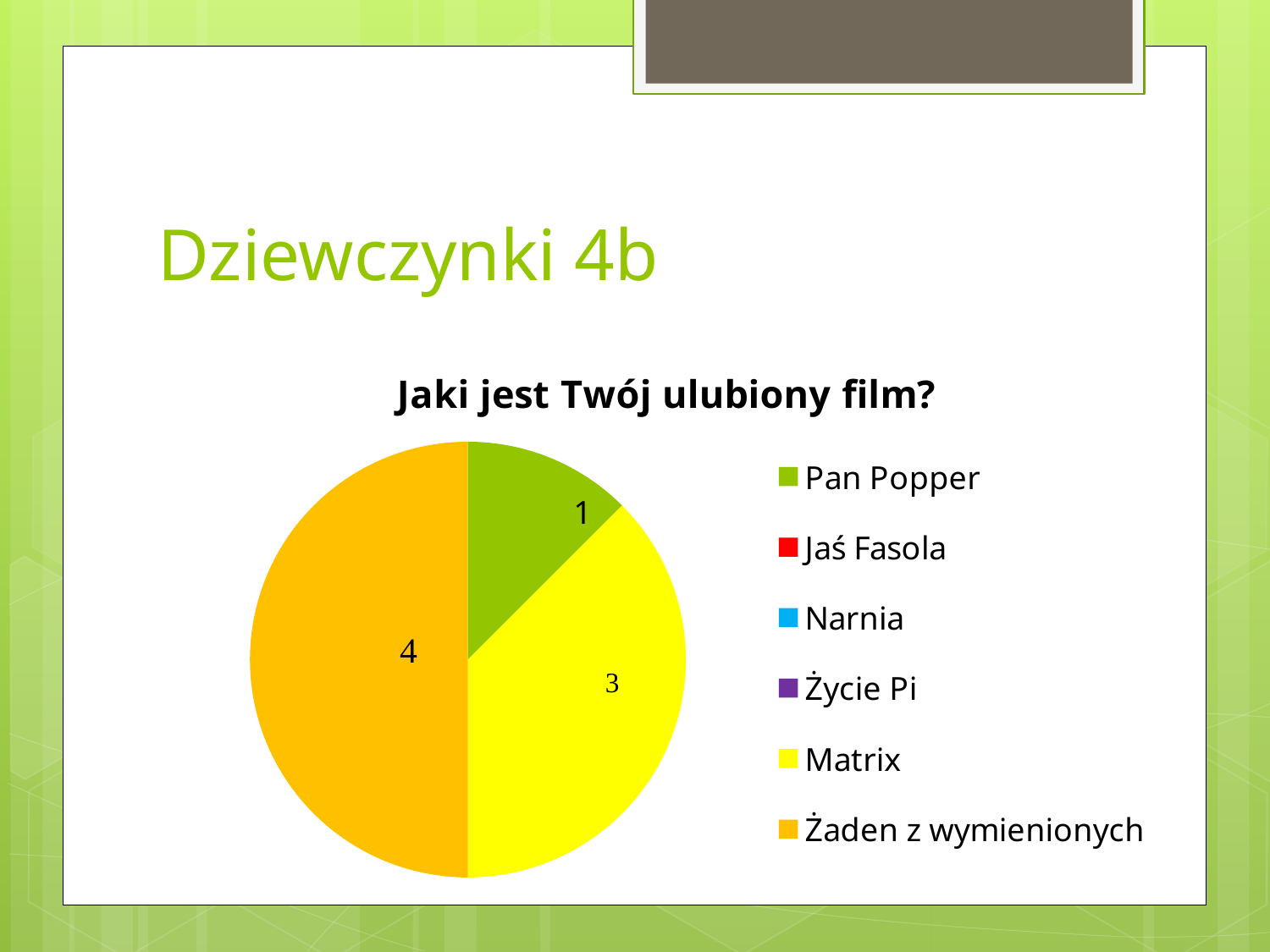
What is the difference between the values for Żaden z wymienionych and Matrix? 1 What is the value for Matrix? 3 How many slices are visible in the pie chart? 3 What is the value for Żaden z wymienionych? 4 What type of chart is shown on the slide? pie chart What share of the pie does Żaden z wymienionych represent? 50% Which is larger, the value for Matrix or the value for Pan Popper? Matrix How many entries does the chart legend list? 6 What is the value for Pan Popper? 1 What is the title of the chart? Jaki jest Twój ulubiony film? Which visible slice is the smallest? Pan Popper Which category has the largest slice? Żaden z wymienionych